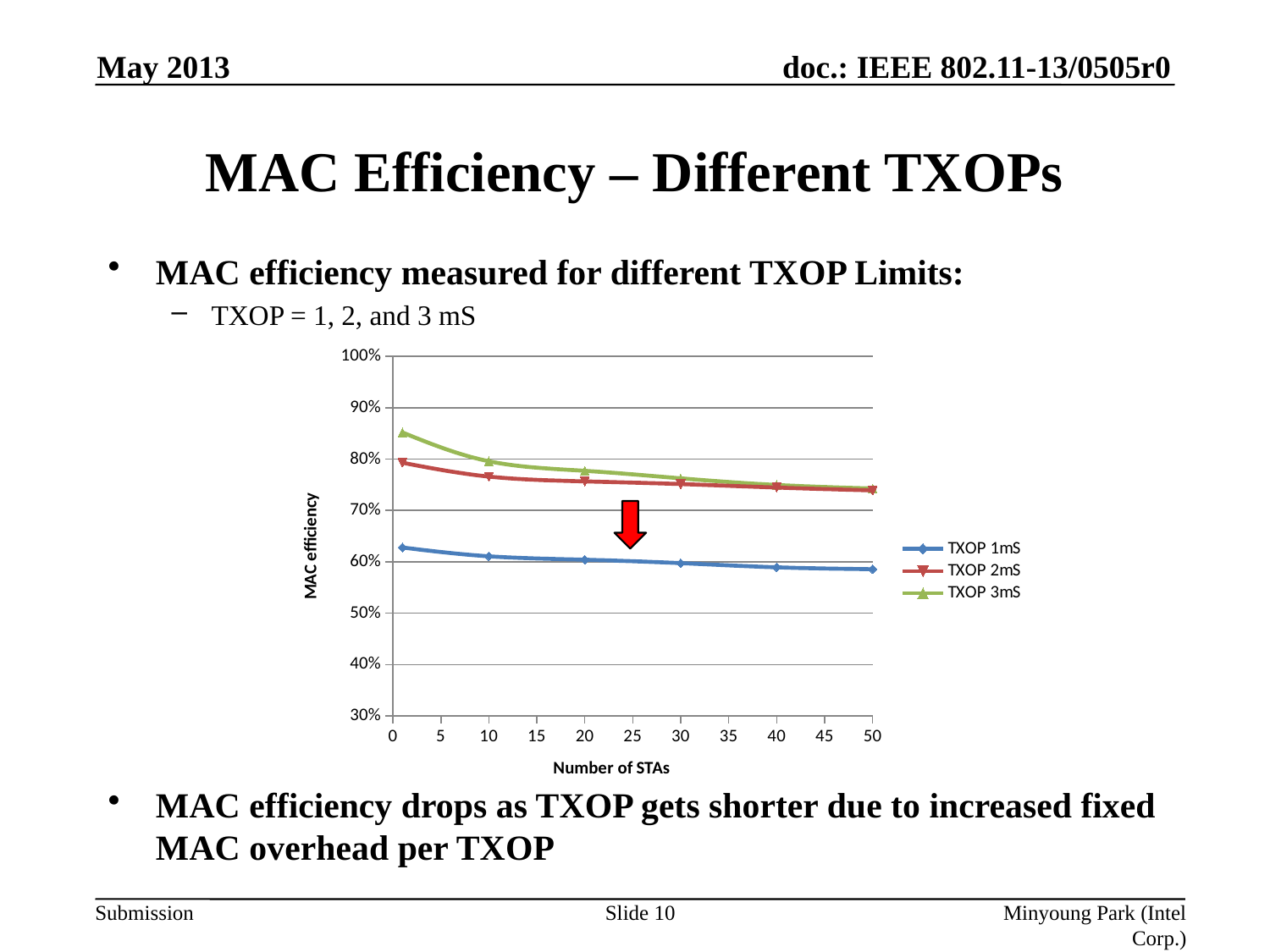
Is the MAC efficiency for TXOP 3mS at 1 STA greater or less than 80%? greater What kind of chart is shown on the slide? line chart How many series does the chart legend list? 3 Which series has the highest MAC efficiency across the number of STAs? TXOP 3mS Does MAC efficiency rise or fall as the number of STAs increases for the TXOP 1mS series? fall Does MAC efficiency rise or fall as the number of STAs increases for the TXOP 3mS series? fall Which series has the lowest MAC efficiency across the number of STAs? TXOP 1mS Is the MAC efficiency for TXOP 1mS at 50 STAs greater or less than 60%? less Is the MAC efficiency for TXOP 2mS at 50 STAs greater or less than 80%? less What is the label of the y axis of the chart? MAC efficiency What is the label of the x axis of the chart? Number of STAs At 10 STAs, which series has the higher MAC efficiency, TXOP 2mS or TXOP 1mS? TXOP 2mS